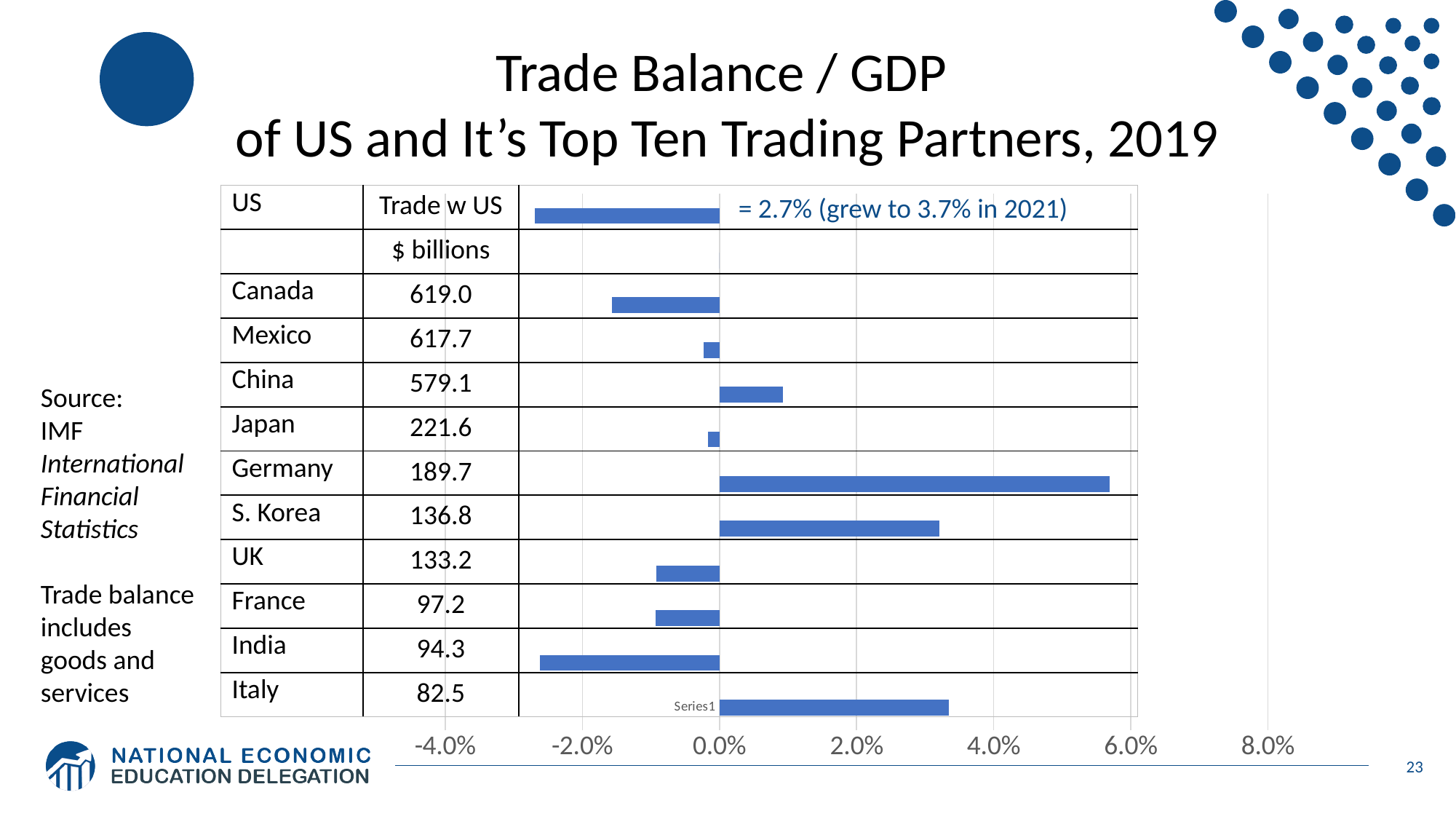
How many countries (including the US) have bars in the chart? 11 Which country has the highest trade balance / GDP bar in the chart? Germany What is the title of the slide containing the chart? Trade Balance / GDP of US and It's Top Ten Trading Partners, 2019 What kind of chart is shown on the slide? bar chart Which has the larger trade balance / GDP bar, Italy or Canada? Italy Is the trade balance / GDP bar for China greater or less than 2.0%? less Is the trade balance / GDP bar for India greater or less than -2.0%? less Which has the larger trade balance / GDP bar, Germany or S. Korea? Germany Is the trade balance / GDP bar for S. Korea greater or less than 2.0%? greater According to the table next to the chart, what is Canada's trade with the US in $ billions? 619.0